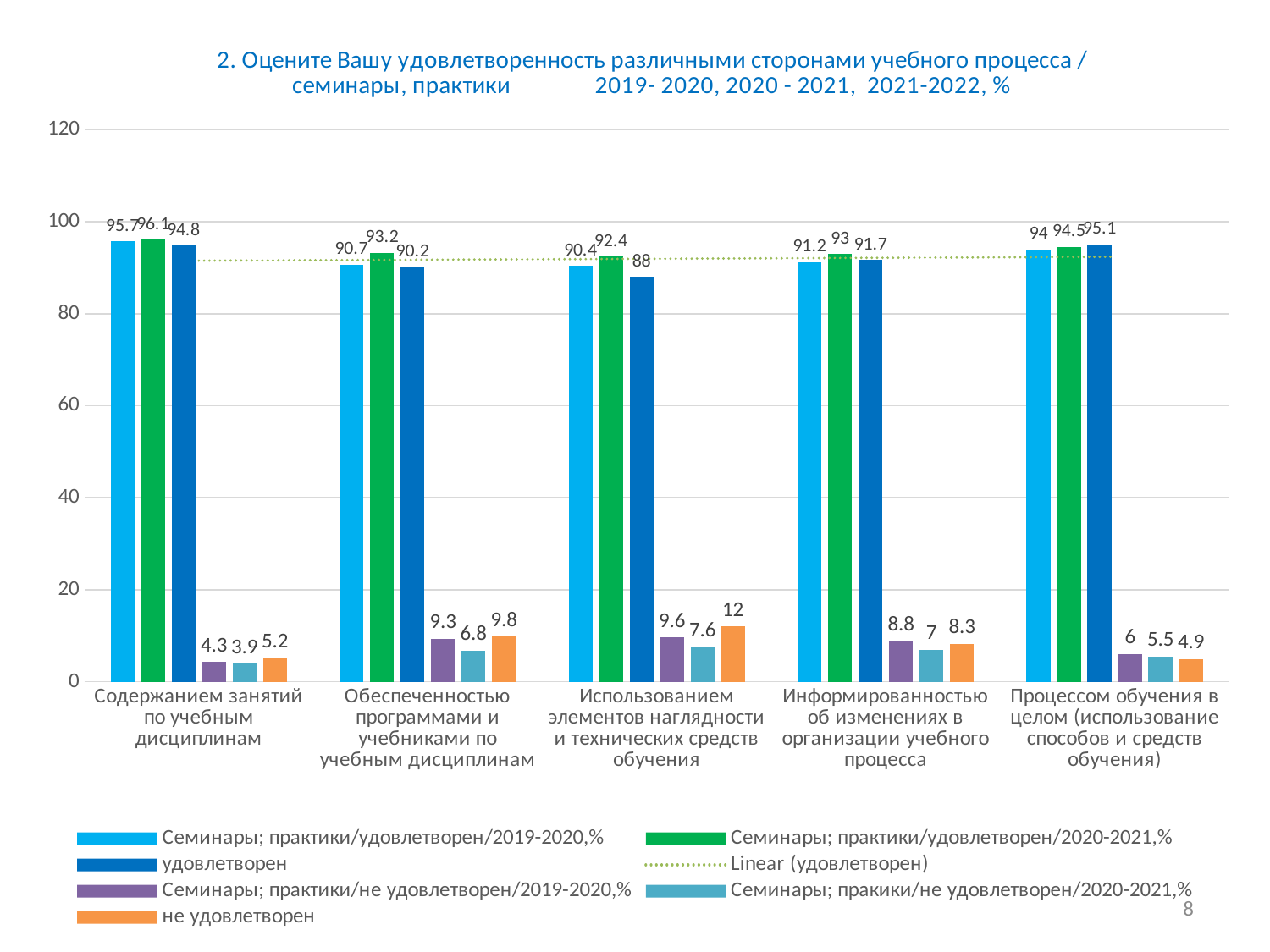
How many categories are shown on the x axis? 5 Which category has the lowest value for the 'удовлетворен' series? Использованием элементов наглядности и технических средств обучения What is the value of the 'Семинары; пракики/не удовлетворен/2020-2021,%' series for 'Информированностью об изменениях в организации учебного процесса'? 7 What is the value of the 'не удовлетворен' series for 'Использованием элементов наглядности и технических средств обучения'? 12 What kind of chart is shown on the slide? Bar chart For 'Обеспеченностью программами и учебниками по учебным дисциплинам', which is larger: the 'Семинары; практики/не удовлетворен/2019-2020,%' value or the 'не удовлетворен' value? не удовлетворен What is the maximum value shown on the vertical axis? 120 What is the difference between the 'Семинары; практики/удовлетворен/2020-2021,%' value and the 'удовлетворен' value for 'Использованием элементов наглядности и технических средств обучения'? 4.4 Which category has the highest value for the 'Семинары; практики/удовлетворен/2019-2020,%' series? Содержанием занятий по учебным дисциплинам How many entries does the legend list? 7 What is the value of the 'Семинары; практики/удовлетворен/2020-2021,%' series for 'Содержанием занятий по учебным дисциплинам'? 96.1 What is the value of the 'удовлетворен' series for 'Процессом обучения в целом (использование способов и средств обучения)'? 95.1